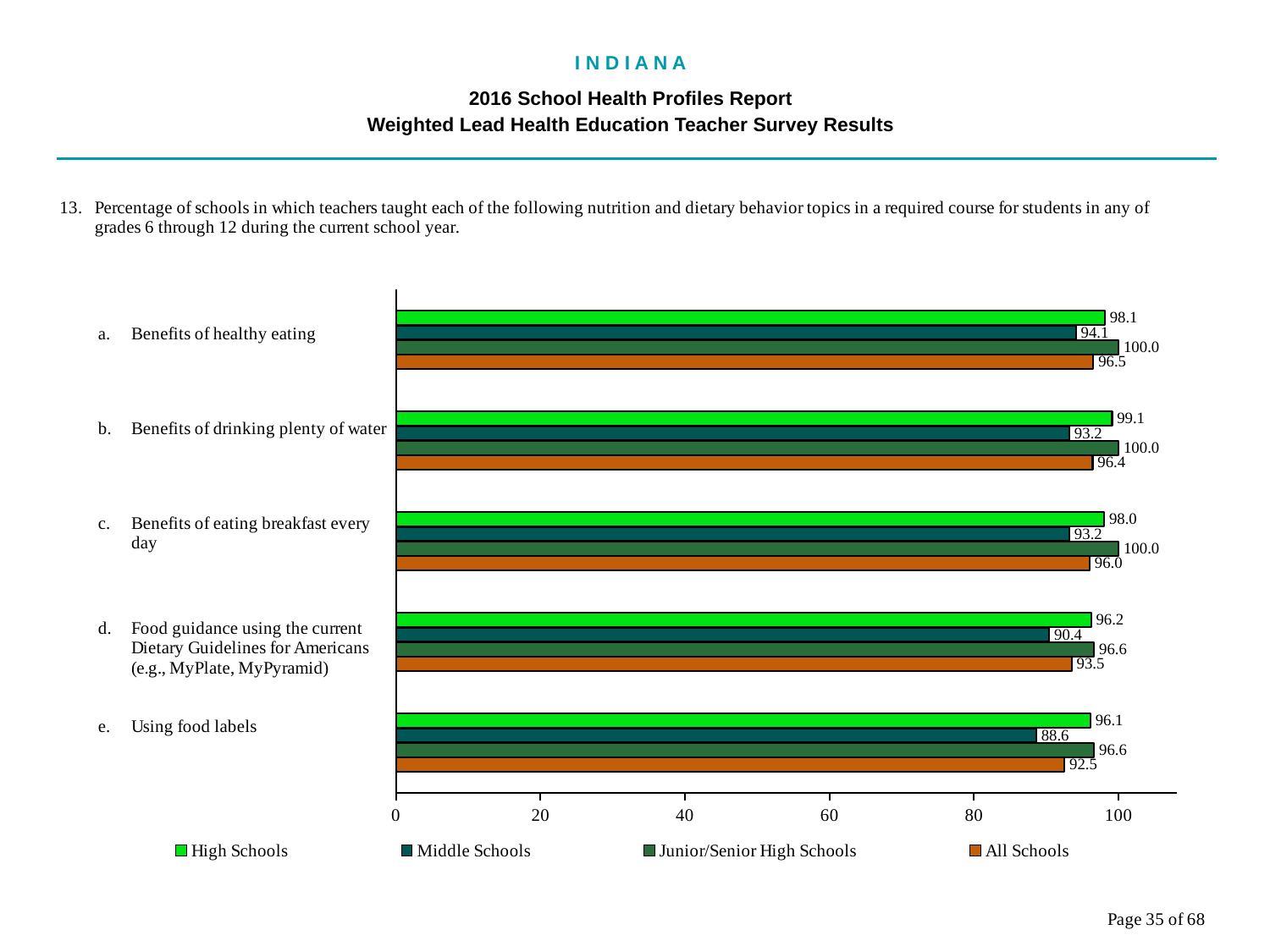
What is the difference between the High Schools and Middle Schools values for 'Using food labels'? 7.5 What is the value for High Schools for 'Benefits of healthy eating'? 98.1 What is the value for Middle Schools for 'Using food labels'? 88.6 Which series is shown in orange in the legend? All Schools Which topic has the highest value for High Schools? Benefits of drinking plenty of water What is the value for All Schools for 'Food guidance using the current Dietary Guidelines for Americans (e.g., MyPlate, MyPyramid)'? 93.5 Which topic has the lowest value for Middle Schools? Using food labels How many series does the legend list? 4 How many topics (categories) are shown in the chart? 5 What is the value for Junior/Senior High Schools for 'Benefits of drinking plenty of water'? 100.0 Which is larger for 'Benefits of eating breakfast every day': the High Schools value or the All Schools value? High Schools What kind of chart is shown on the slide? Bar chart